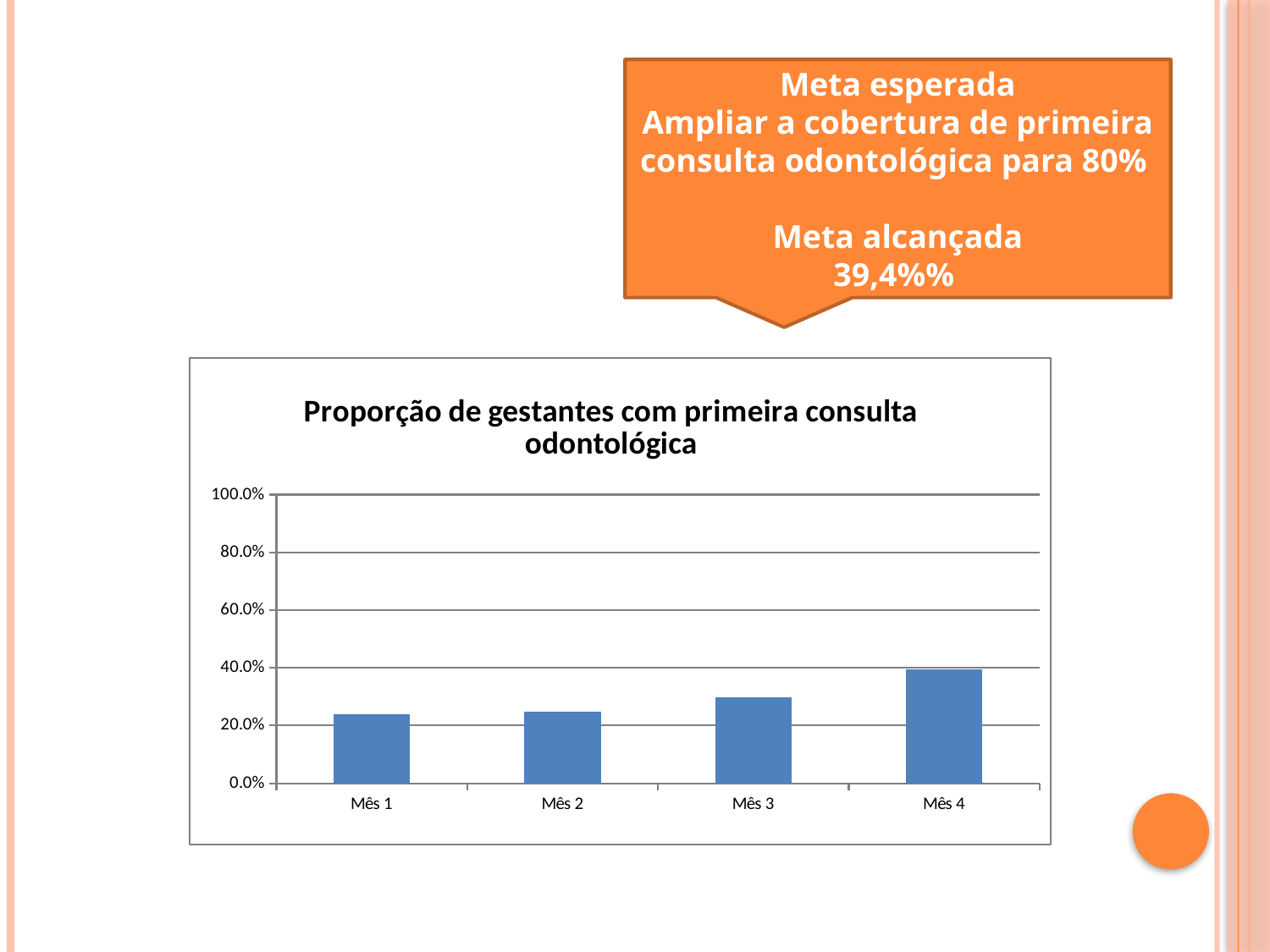
Which is larger, the value for Mês 3 or the value for Mês 1? Mês 3 Is the value for Mês 2 greater or less than 40.0%? less Which is larger, the value for Mês 4 or the value for Mês 2? Mês 4 What is the highest value shown on the vertical axis of the chart? 100.0% What kind of chart is shown on the slide? bar chart Which month has the highest proportion of pregnant women with a first dental consultation? Mês 4 What is the title of the chart? Proporção de gestantes com primeira consulta odontológica Do the values rise or fall from Mês 1 to Mês 4? rise Is the value for Mês 3 greater or less than 40.0%? less Is the value for Mês 1 greater or less than 20.0%? greater How many months (categories) are plotted on the chart? 4